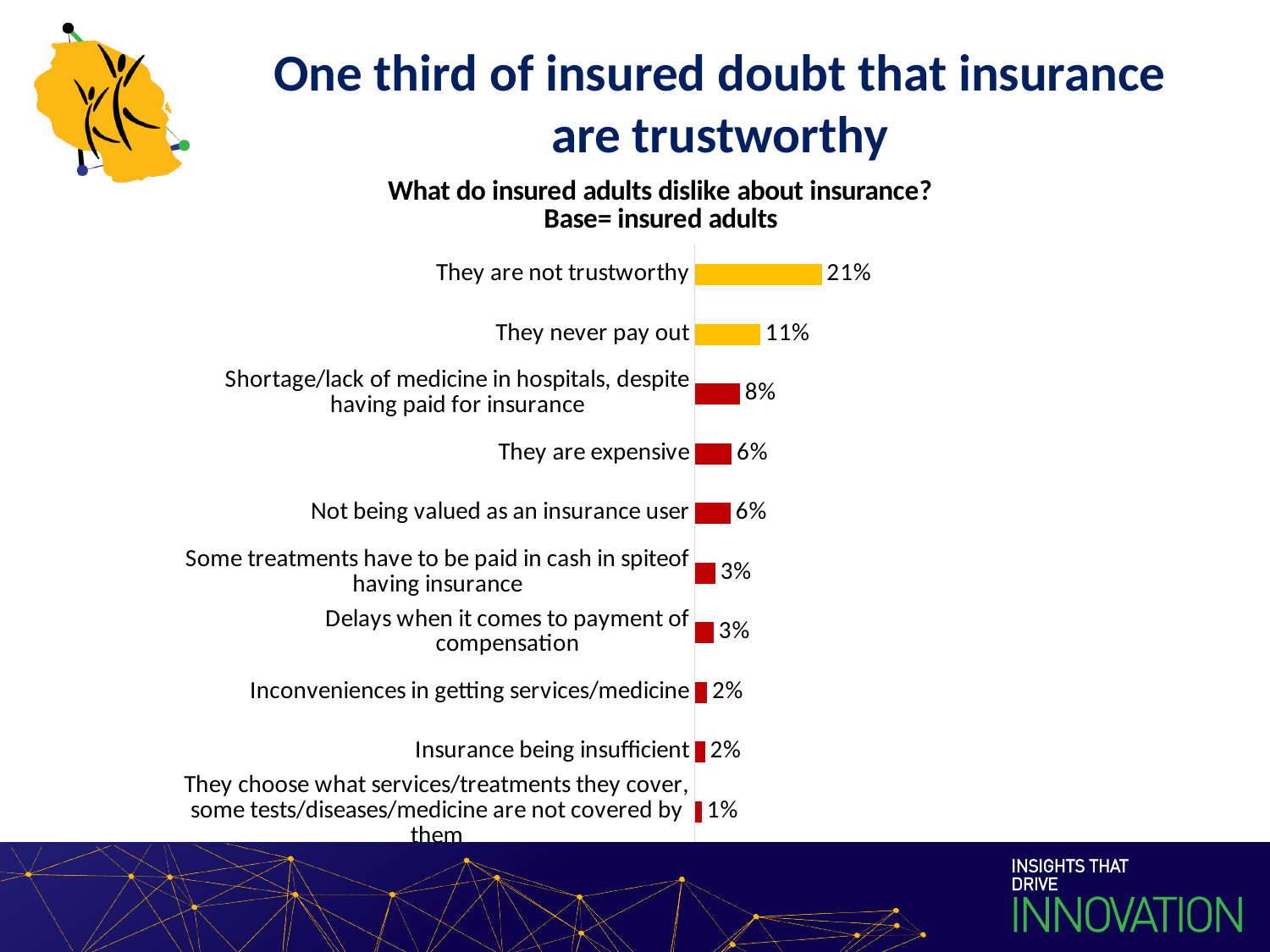
What kind of chart is shown on the slide? Bar chart What is the difference between 'They are expensive' and 'Insurance being insufficient'? 4% Which is larger: 'They are expensive' or 'Shortage/lack of medicine in hospitals, despite having paid for insurance'? Shortage/lack of medicine in hospitals, despite having paid for insurance What is the chart's title? What do insured adults dislike about insurance? Base= insured adults What percentage of insured adults say insurance providers are not trustworthy? 21% Which dislike has the lowest percentage? They choose what services/treatments they cover, some tests/diseases/medicine are not covered by them How many categories are shown in the chart? 10 Which dislike has the highest percentage? They are not trustworthy What is the value for 'Delays when it comes to payment of compensation'? 3% What percentage cite shortage/lack of medicine in hospitals, despite having paid for insurance? 8% What is the value for 'They never pay out'? 11% What is the difference between 'They are not trustworthy' and 'They never pay out'? 10%